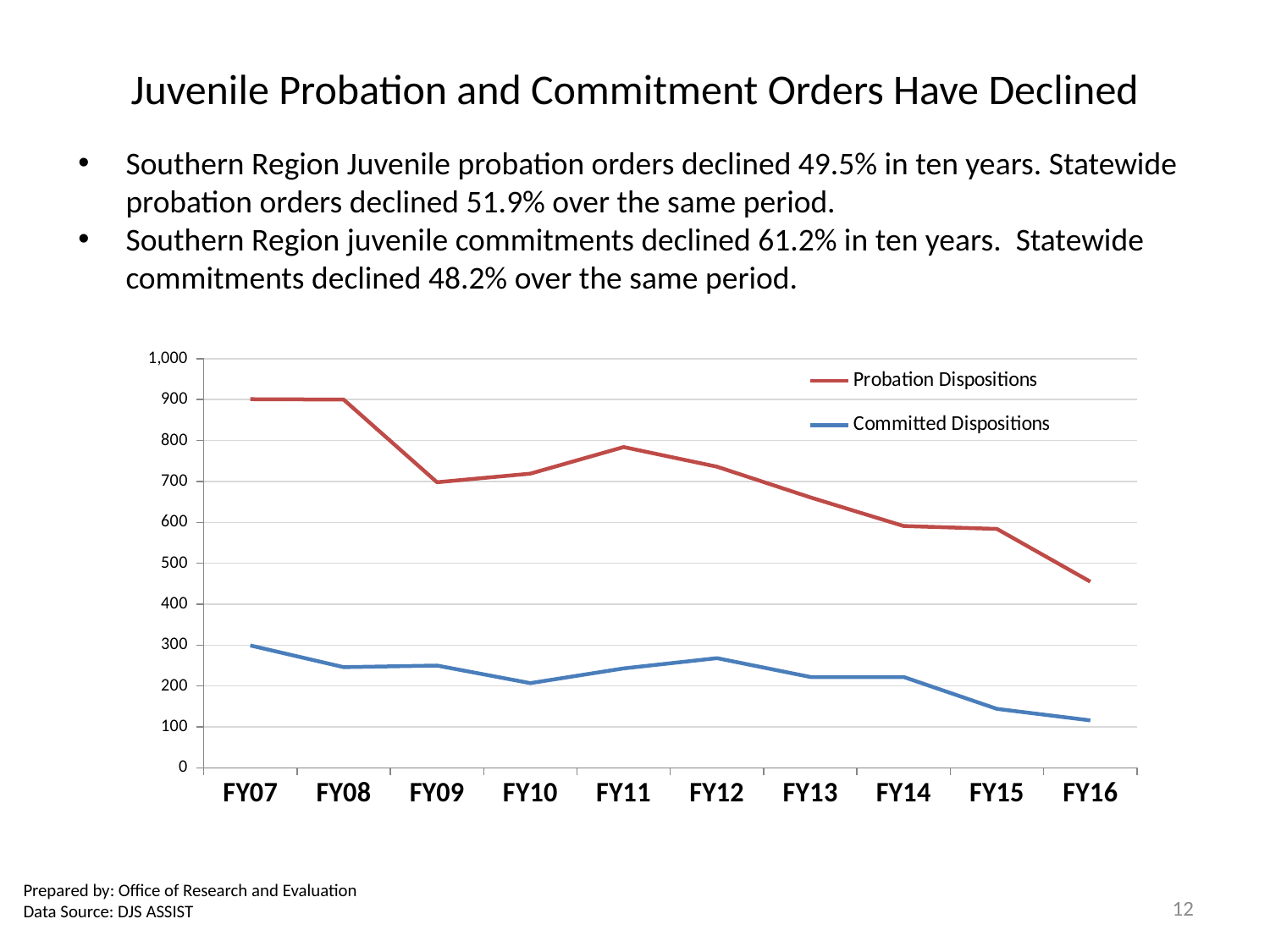
How many series does the chart legend list? 2 In which fiscal year is the Probation Dispositions value lowest? FY16 How many fiscal years are plotted along the x axis? 10 What kind of chart is shown on the slide? line chart Is the value for Probation Dispositions in FY16 greater or less than 500? less Which series is drawn in red? Probation Dispositions Is the value for Probation Dispositions in FY11 greater or less than 700? greater Is the value for Committed Dispositions in FY16 greater or less than 200? less Which is larger for Probation Dispositions, the value in FY09 or the value in FY11? FY11 Overall, do the Probation Dispositions values rise or fall from FY07 to FY16? fall In which fiscal year is the Committed Dispositions value lowest? FY16